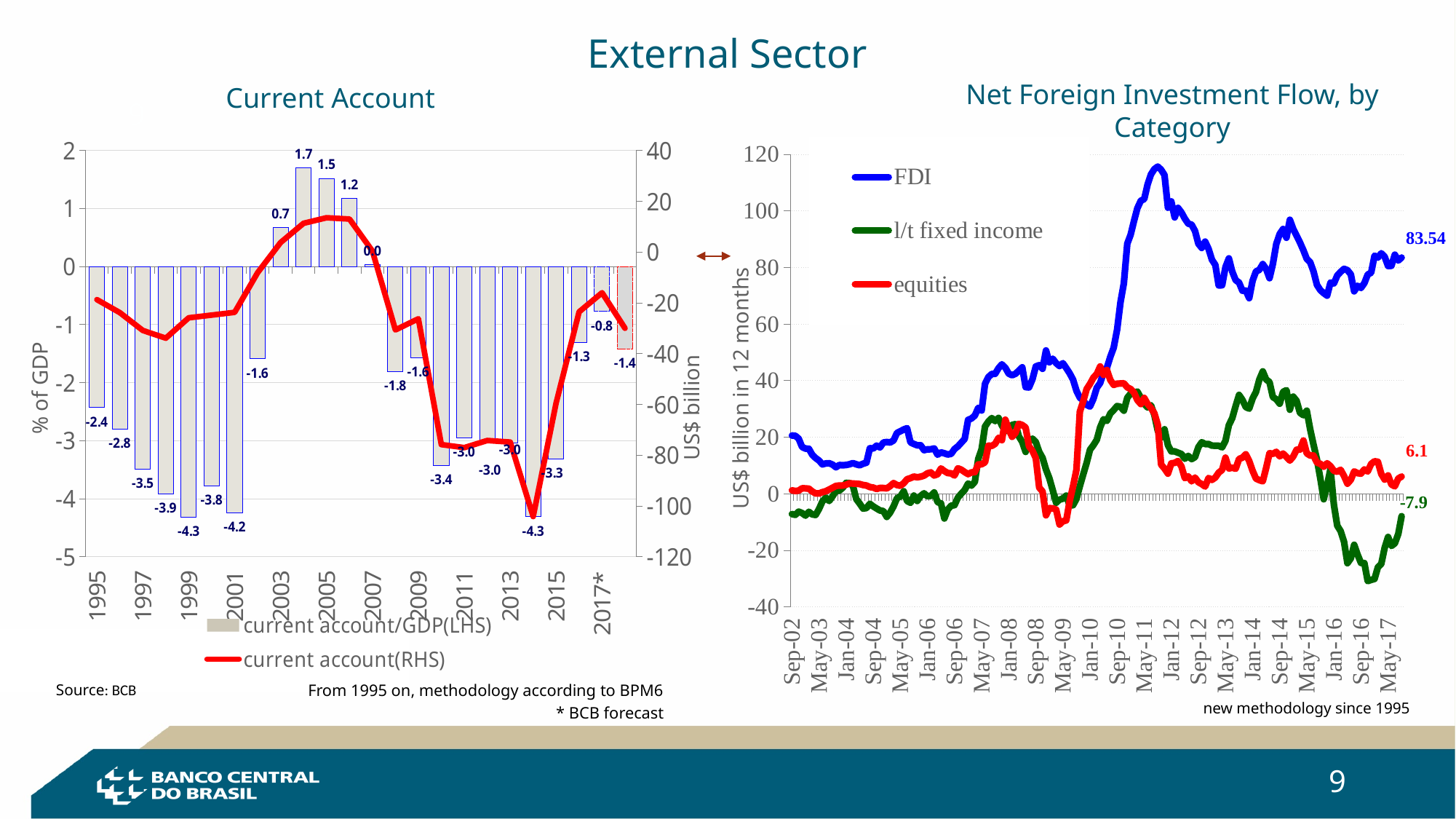
In the 'Net Foreign Investment Flow, by Category' chart, what is the latest labelled value for equities? 6.1 In the 'Net Foreign Investment Flow, by Category' chart, what is the latest labelled value for l/t fixed income? -7.9 In the 'Net Foreign Investment Flow, by Category' chart, which series has the highest value at the end of the period? FDI How many series does the legend of the 'Net Foreign Investment Flow, by Category' chart list? 3 In the 'Current Account' chart, what is the current account/GDP value for 1995? -2.4 What type of chart is the 'Net Foreign Investment Flow, by Category' chart? Line chart In the 'Net Foreign Investment Flow, by Category' chart, is the peak value of FDI greater or less than 100? greater In the 'Current Account' chart, what is the current account/GDP value for 2017*? -0.8 In the 'Net Foreign Investment Flow, by Category' chart, what is the latest labelled value for FDI? 83.54 In the 'Current Account' chart, what is the highest current account/GDP value shown on the bars? 1.7 In the 'Current Account' chart, which year has the larger current account/GDP value, 2003 or 2005? 2005 In the 'Current Account' chart, what is the difference between the current account/GDP values for 1995 (-2.4) and 1997 (-3.5)? 1.1